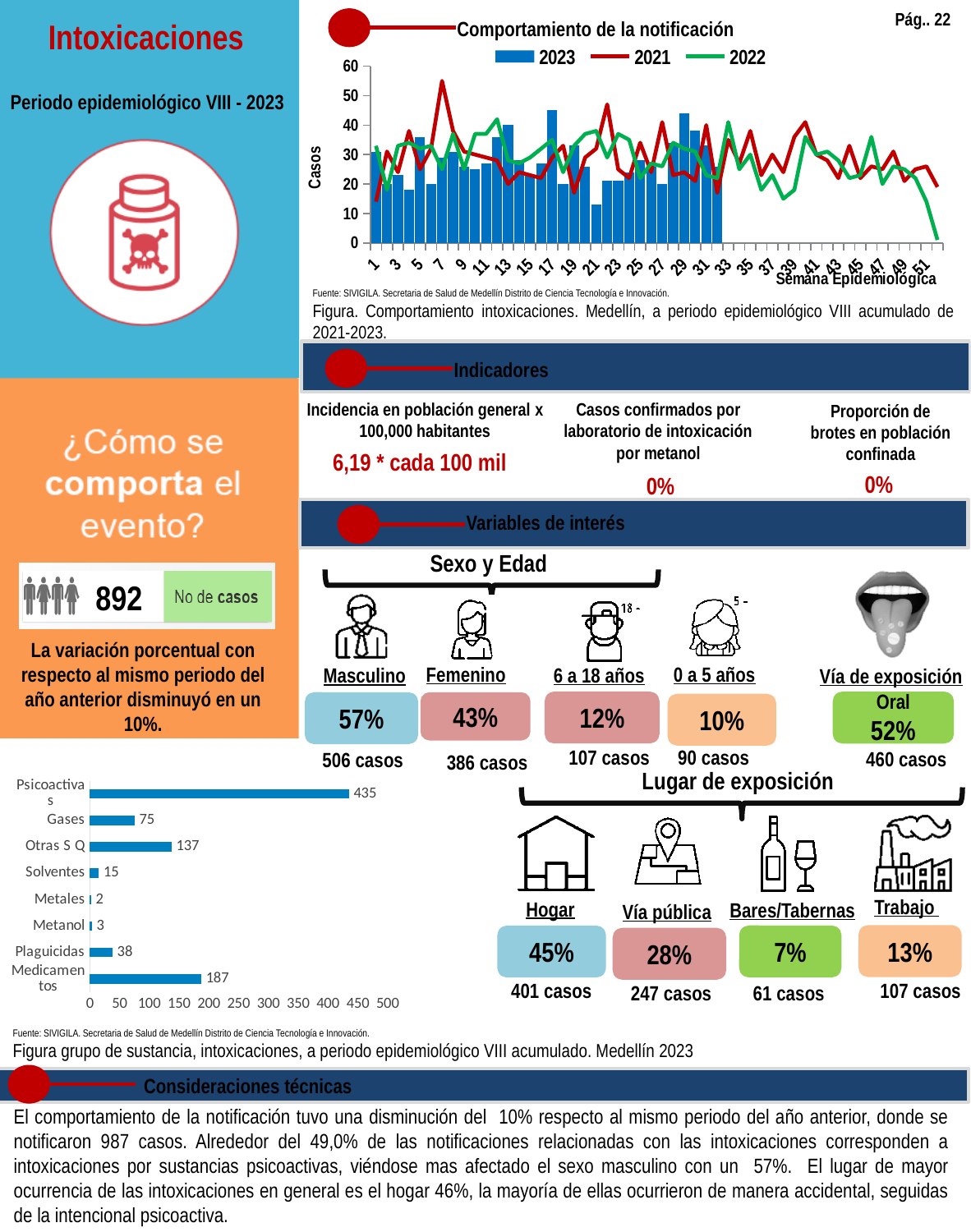
In the bottom-left bar chart of substance groups, which category has the lowest value? Metales How many series does the legend of the 'Comportamiento de la notificación' chart list? 3 In the bottom-left bar chart of substance groups, what is the value for Psicoactivas? 435 In the bottom-left bar chart of substance groups, which is larger, Gases or Otras S Q? Otras S Q In the bottom-left bar chart of substance groups, what is the difference between Psicoactivas and Medicamentos? 248 How many categories are shown in the bottom-left bar chart of substance groups? 8 In the bottom-left bar chart of substance groups, what is the value for Medicamentos? 187 In the 'Comportamiento de la notificación' chart, is the 2023 value at week 17 greater or less than 40? greater What kind of chart is the bottom-left chart of substance groups? Bar chart In the 'Comportamiento de la notificación' chart, which series is drawn as bars? 2023 In the bottom-left bar chart of substance groups, what is the value for Plaguicidas? 38 In the bottom-left bar chart of substance groups, which category has the highest value? Psicoactivas